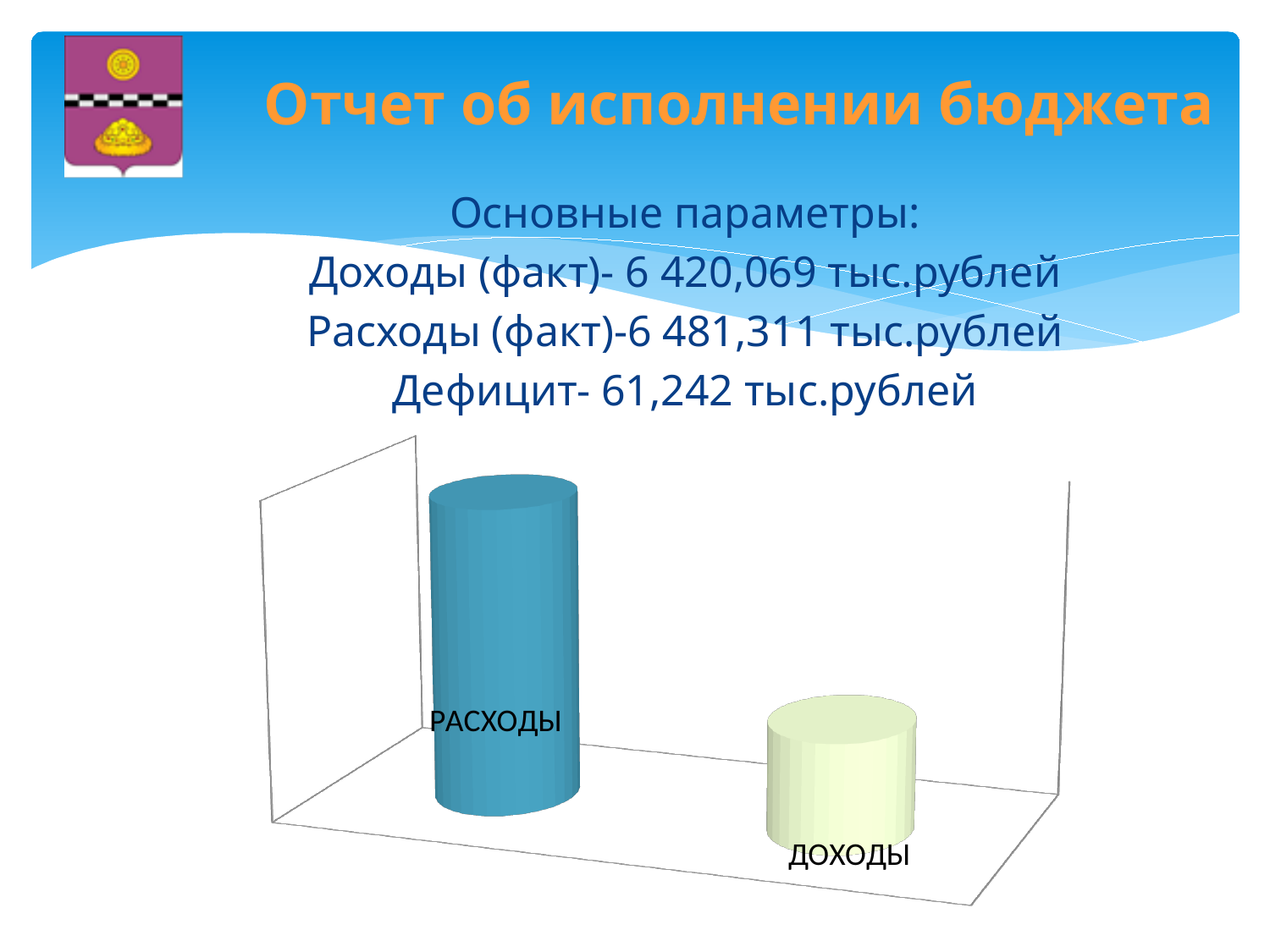
Which bar is taller, РАСХОДЫ or ДОХОДЫ? РАСХОДЫ Which category has the tallest bar in the chart? РАСХОДЫ What kind of chart is shown on the slide? bar chart How many categories (bars) does the chart show? 2 What colour is the bar for РАСХОДЫ? blue What colour is the bar for ДОХОДЫ? pale yellow Which category has the shortest bar in the chart? ДОХОДЫ